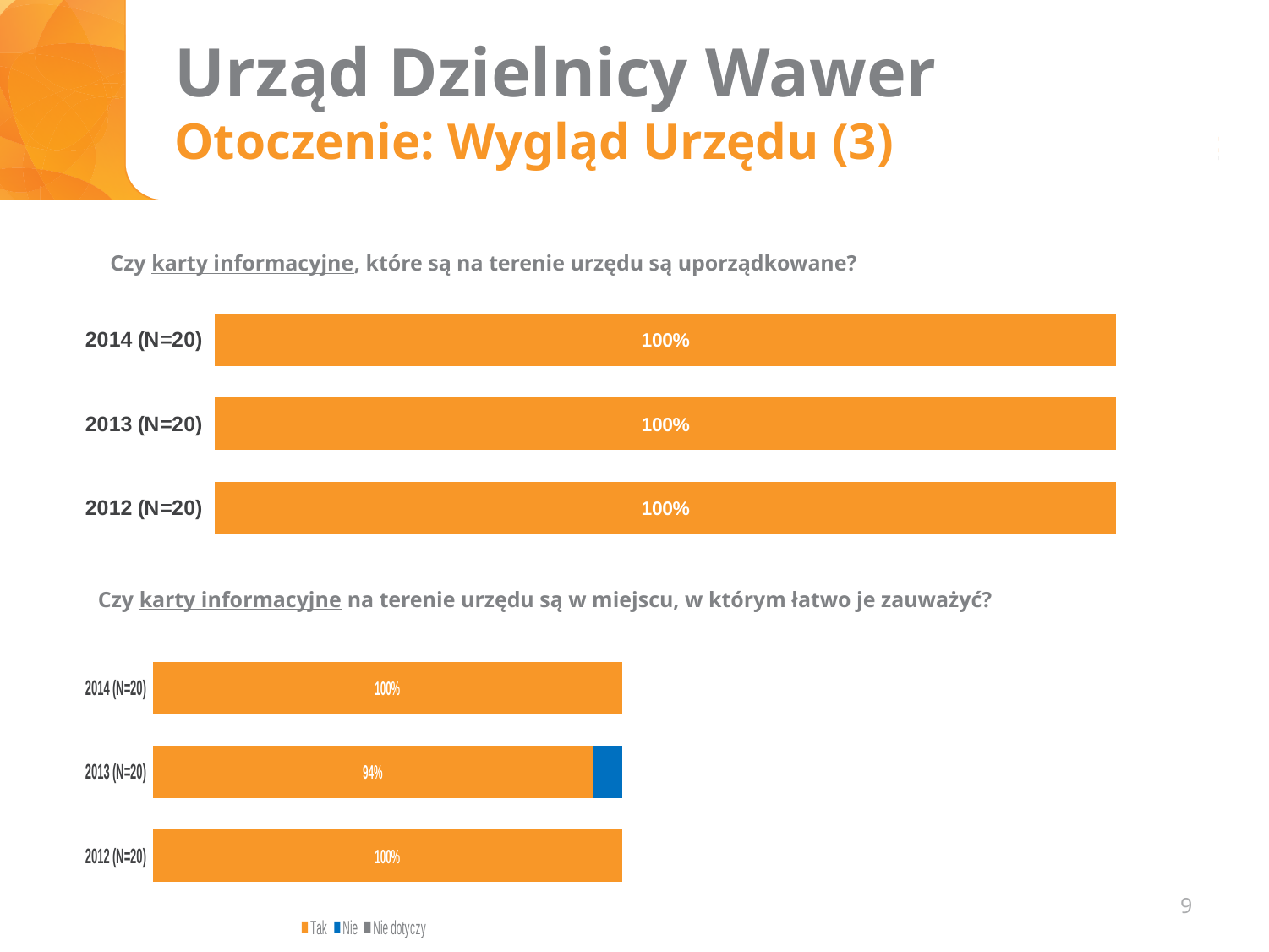
In the bottom chart ("Czy karty informacyjne na terenie urzędu są w miejscu, w którym łatwo je zauważyć?"), which year's bar includes a blue "Nie" segment? 2013 (N=20) In the bottom chart ("Czy karty informacyjne na terenie urzędu są w miejscu, w którym łatwo je zauważyć?"), what is the "Tak" value for 2014 (N=20)? 100% In the top chart ("Czy karty informacyjne, które są na terenie urzędu są uporządkowane?"), what is the value shown for 2014 (N=20)? 100% In the top chart ("Czy karty informacyjne, które są na terenie urzędu są uporządkowane?"), what is the value shown for 2012 (N=20)? 100% How many series does the legend of the bottom chart ("Czy karty informacyjne na terenie urzędu są w miejscu, w którym łatwo je zauważyć?") list? 3 In the bottom chart ("Czy karty informacyjne na terenie urzędu są w miejscu, w którym łatwo je zauważyć?"), what is the "Tak" value for 2013 (N=20)? 94% In the bottom chart ("Czy karty informacyjne na terenie urzędu są w miejscu, w którym łatwo je zauważyć?"), what is the difference between the "Tak" value for 2014 (N=20) and for 2013 (N=20)? 6 percentage points What are the legend entries of the bottom chart ("Czy karty informacyjne na terenie urzędu są w miejscu, w którym łatwo je zauważyć?")? Tak, Nie, Nie dotyczy In the bottom chart ("Czy karty informacyjne na terenie urzędu są w miejscu, w którym łatwo je zauważyć?"), which year has the lowest "Tak" value? 2013 (N=20) In the bottom chart ("Czy karty informacyjne na terenie urzędu są w miejscu, w którym łatwo je zauważyć?"), which is larger: the "Tak" value for 2012 (N=20) or for 2013 (N=20)? 2012 (N=20) What kind of chart is the top chart ("Czy karty informacyjne, które są na terenie urzędu są uporządkowane?")? Bar chart How many year categories are shown in the top chart ("Czy karty informacyjne, które są na terenie urzędu są uporządkowane?")? 3